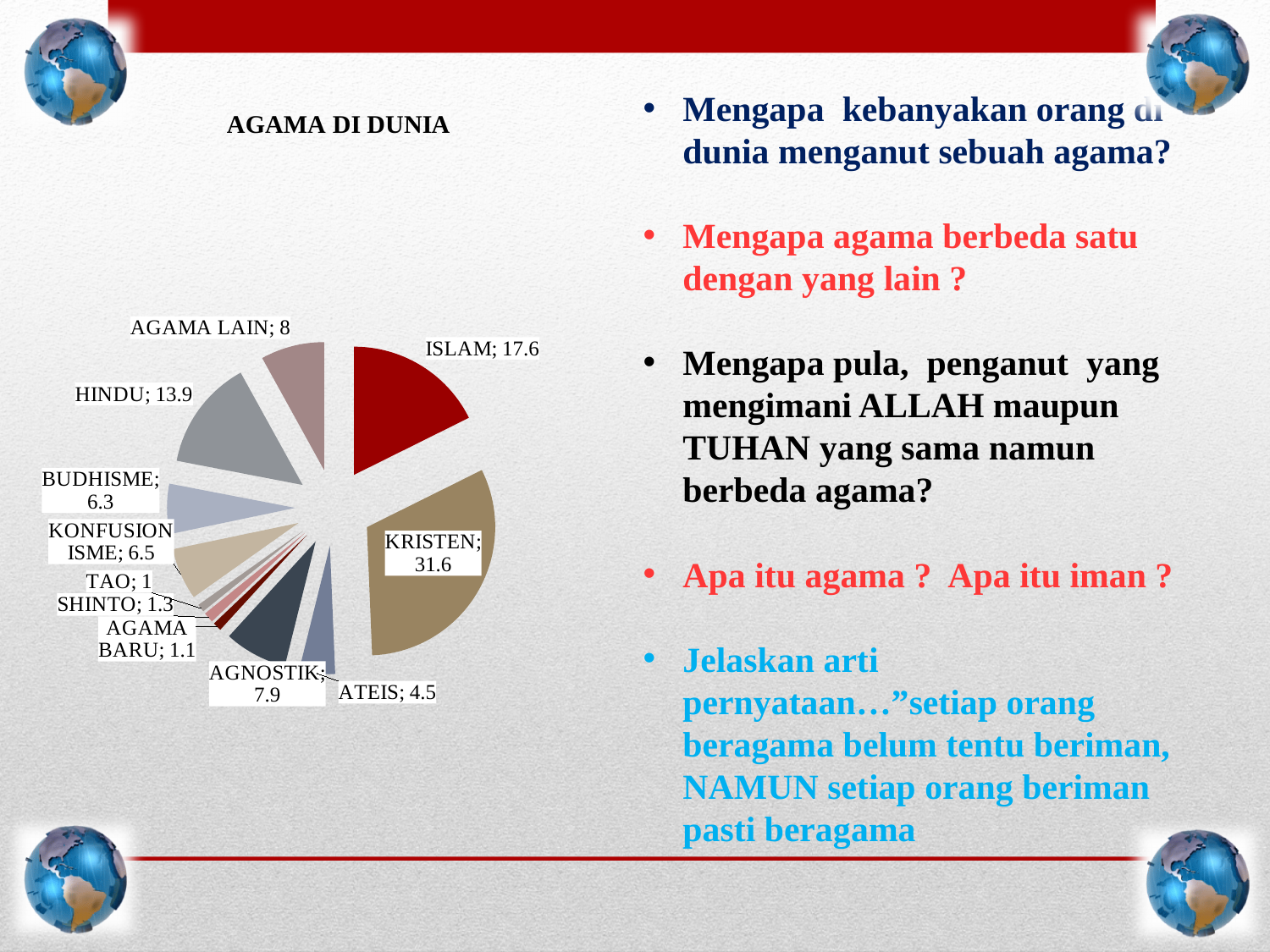
Which category has the largest slice of the pie? KRISTEN What is the difference between the values for KRISTEN and ISLAM? 14 What is the value shown for HINDU? 13.9 What is the value shown for ISLAM? 17.6 Which category has the smallest value in the chart? TAO What is the title of the chart? AGAMA DI DUNIA How many categories are shown in the pie chart? 11 Which is larger, the value for HINDU or the value for AGAMA LAIN? HINDU What is the difference between the values for AGNOSTIK and ATEIS? 3.4 What is the value shown for AGNOSTIK? 7.9 What type of chart is shown on the slide? pie chart What is the value shown for KRISTEN? 31.6